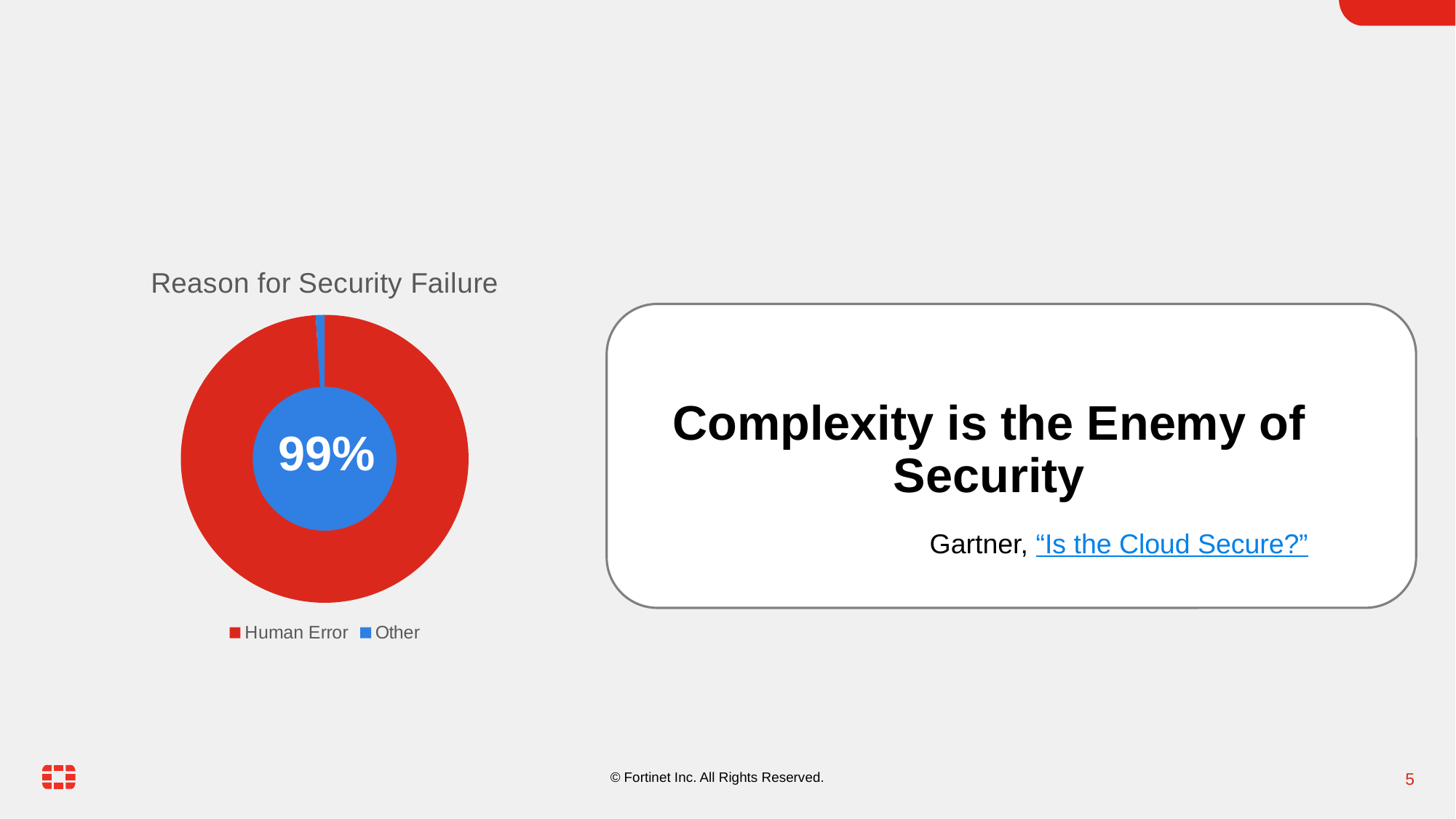
What kind of chart is shown on the slide? doughnut chart What are the two categories shown in the chart's legend? Human Error and Other How many categories does the chart's legend list? 2 Which is larger in the chart, Human Error or Other? Human Error What value is printed in the centre of the chart? 99% Which category accounts for the largest share of the chart? Human Error What share of security failures is attributed to Human Error according to the chart? 99% What colour represents Human Error in the chart? red What is the title of the chart on the slide? Reason for Security Failure Which category accounts for the smallest share of the chart? Other